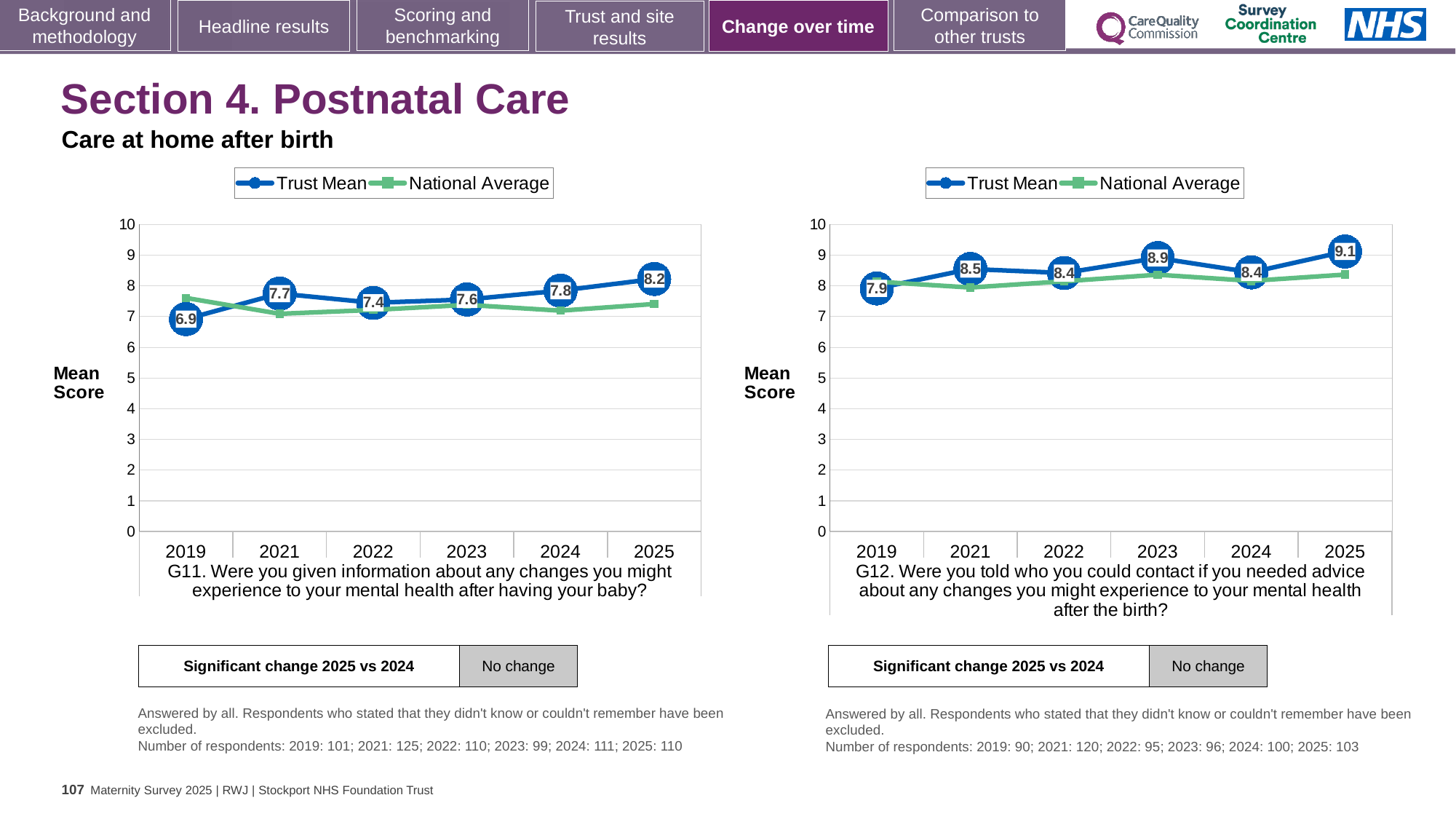
In the G12 chart on the right, which year has the highest Trust Mean? 2025 In the G11 chart on the left, is the National Average for 2019 greater or less than 7? greater In the G12 chart on the right, what is the Trust Mean for 2023? 8.9 In the G11 chart on the left, is the Trust Mean for 2021 or for 2022 higher? 2021 In the G12 chart on the right, is the National Average for 2025 greater or less than 8? greater In the G11 chart on the left, what is the difference between the Trust Mean for 2025 and the Trust Mean for 2019? 1.3 What type of chart is the G11 chart on the left? Line chart How many series does the legend of the G11 chart on the left list? 2 In the G11 chart on the left, what is the Trust Mean for 2025? 8.2 In the G12 chart on the right, what is the difference between the Trust Mean for 2025 and the Trust Mean for 2024? 0.7 In the G11 chart on the left, which year has the lowest Trust Mean? 2019 How many years are shown on the x axis of the G12 chart on the right? 6